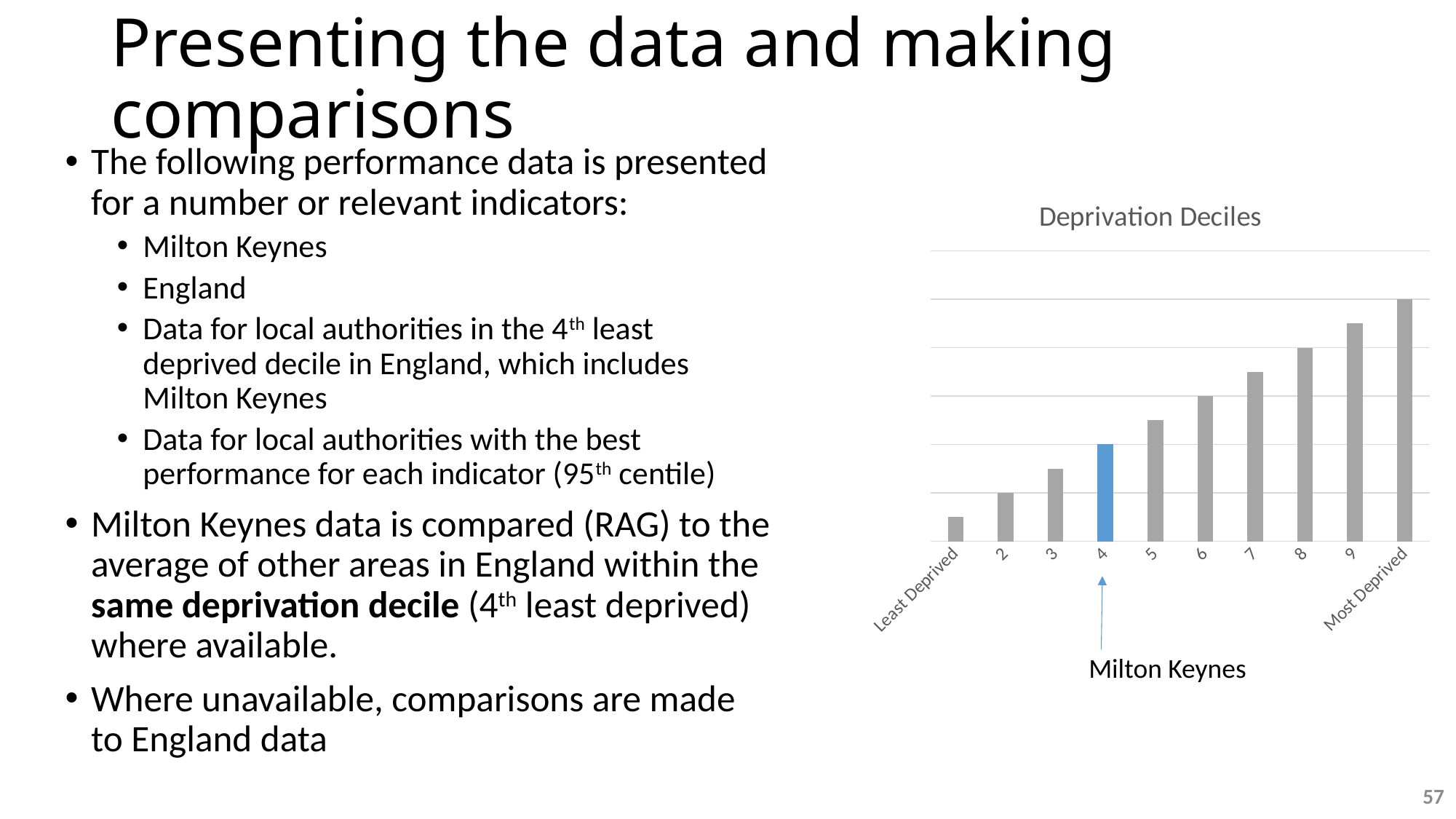
What is the title of the chart? Deprivation Deciles Do the bars rise or fall moving from Least Deprived to Most Deprived along the x axis? Rise Which bar is taller, decile 7 or decile 3? 7 Which category has the highest bar in the Deprivation Deciles chart? Most Deprived Which bar is taller, decile 2 or decile 9? 9 Which category has the lowest bar in the Deprivation Deciles chart? Least Deprived Which decile's bar is highlighted in blue in the Deprivation Deciles chart? 4 How many categories (bars) are shown in the Deprivation Deciles chart? 10 What kind of chart is shown on the slide? Bar chart Is the bar for decile 5 taller or shorter than the bar for decile 8? Shorter